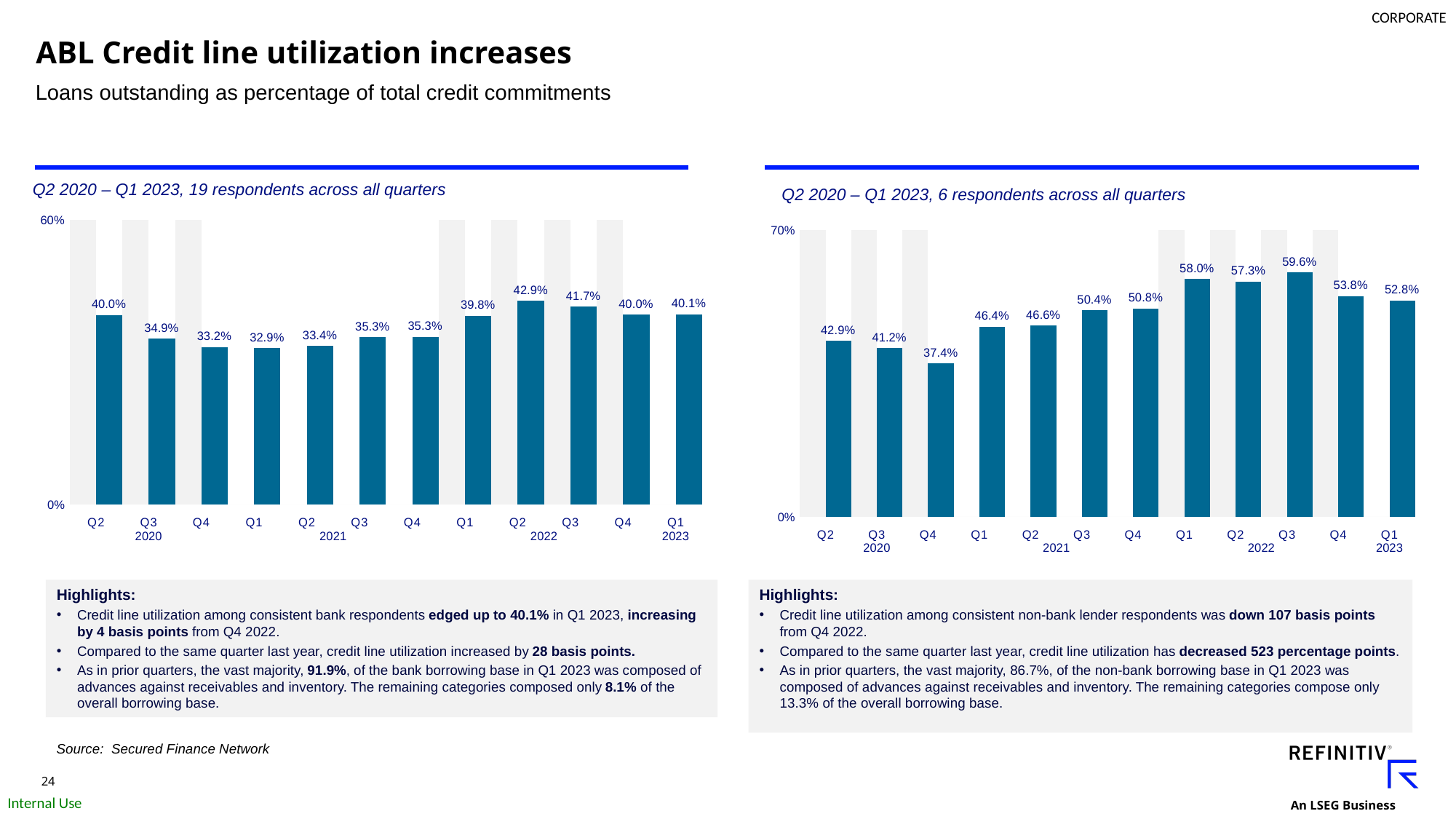
On the left chart (19 respondents), which is larger: the value for Q2 2020 or the value for Q3 2020? Q2 2020 On the right chart (6 respondents), what is the difference between the Q3 2022 value and the Q1 2023 value? 6.8% On the left chart (19 respondents), which quarter has the highest value? Q2 2022 How many bars are plotted on the left chart (19 respondents)? 12 What kind of chart is the right chart (6 respondents)? bar chart On the left chart (19 respondents), what is the value for Q1 2023? 40.1% On the right chart (6 respondents), is the value for Q1 2022 greater or less than 70%? less On the right chart (6 respondents), what is the value for Q4 2020? 37.4% On the right chart (6 respondents), which quarter has the lowest value? Q4 2020 On the right chart (6 respondents), which quarter has the highest value? Q3 2022 On the left chart (19 respondents), which quarter has the lowest value? Q1 2021 What is the title of the left chart? Q2 2020 – Q1 2023, 19 respondents across all quarters